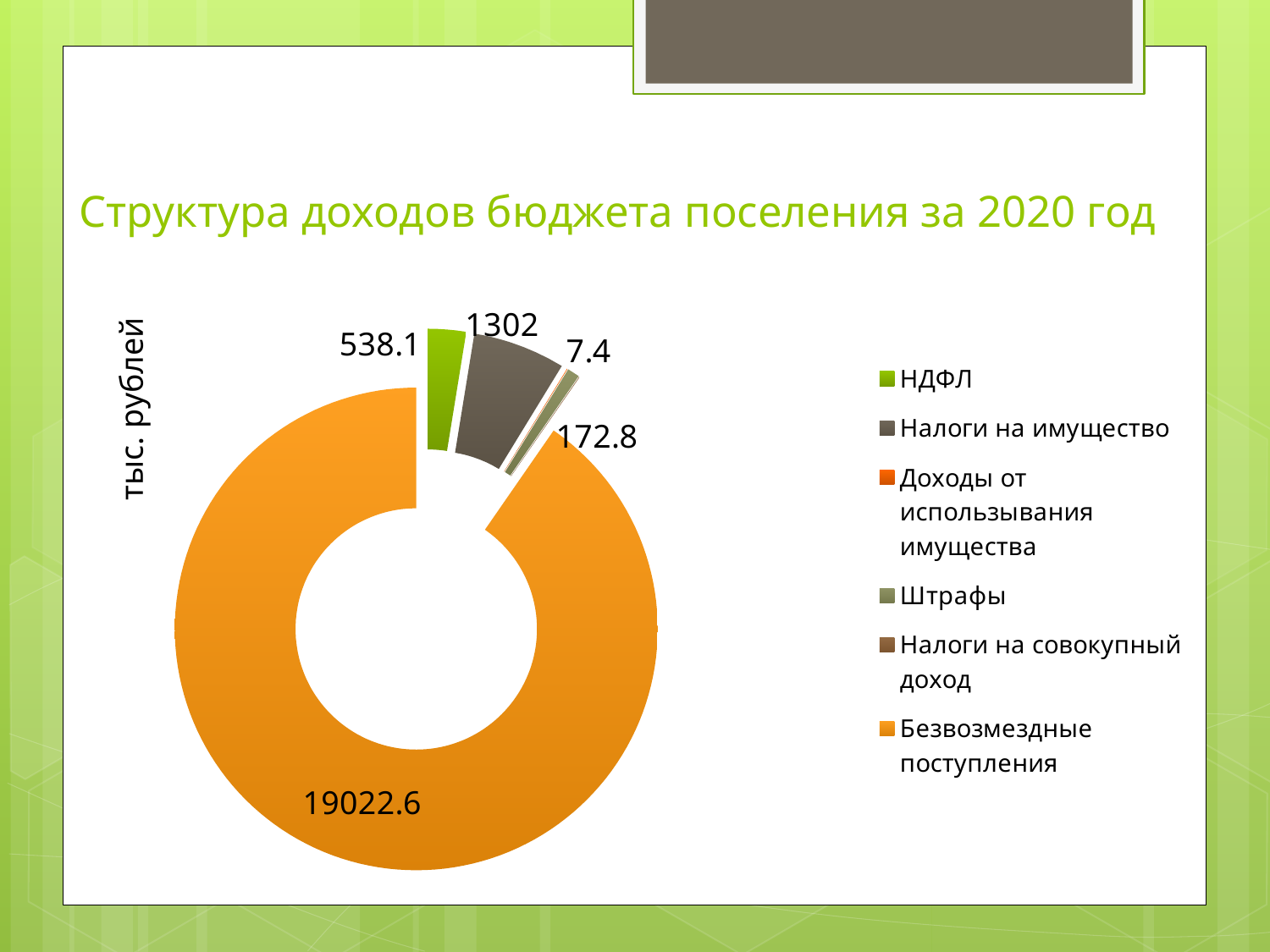
What unit is indicated on the chart's axis label? тыс. рублей What is the value for НДФЛ? 538.1 What is the value for Налоги на имущество? 1302 Which category has the largest value in the chart? Безвозмездные поступления What type of chart is shown on the slide? Doughnut (pie) chart Is the value for Безвозмездные поступления greater or less than 10000? greater What is the title of the chart on the slide? Структура доходов бюджета поселения за 2020 год What is the value for Безвозмездные поступления? 19022.6 Which is larger, НДФЛ or Налоги на имущество? Налоги на имущество What is the difference between Налоги на имущество and НДФЛ? 763.9 How many categories does the chart legend list? 6 What is the difference between Безвозмездные поступления and Налоги на имущество? 17720.6